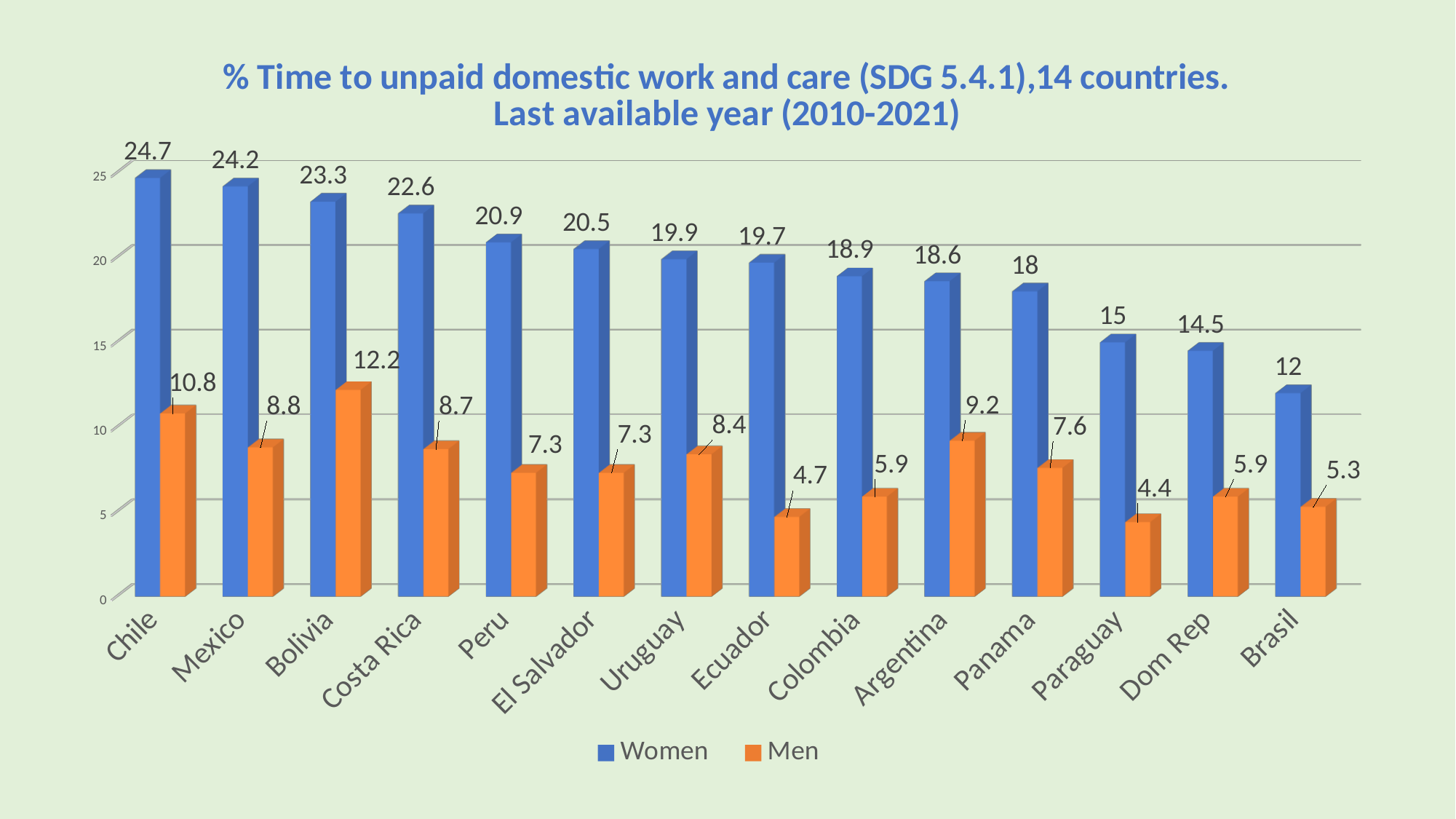
What is the value for Men in Ecuador? 4.7 Which is larger, the Men value for Argentina or the Men value for Panama? Argentina Do the Women values rise or fall from left to right along the x axis? Fall How many series does the legend list? 2 How many countries are shown on the x axis? 14 What is the value for Women in Chile? 24.7 Which country has the highest value for Men? Bolivia Which country has the lowest value for Women? Brasil Which country has the lowest value for Men? Paraguay What is the value for Men in Bolivia? 12.2 What is the difference between the Women and Men values for Chile? 13.9 What kind of chart is shown on the slide? Bar chart